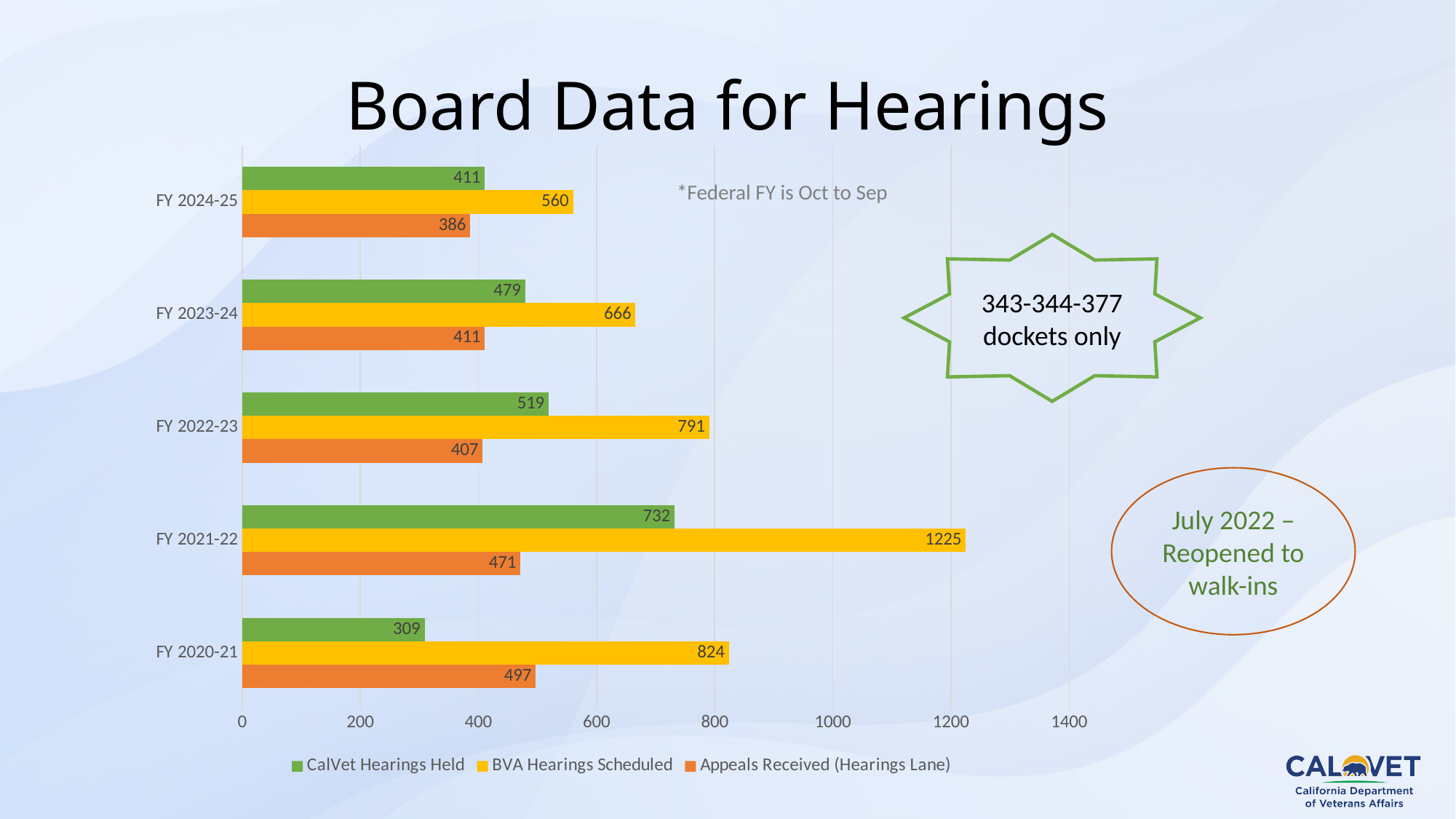
How many series does the legend list? 3 What is the value for CalVet Hearings Held in FY 2024-25? 411 What is the difference between BVA Hearings Scheduled and CalVet Hearings Held in FY 2022-23? 272 How many fiscal years are shown on the chart? 5 Which fiscal year has the lowest value for BVA Hearings Scheduled? FY 2024-25 What is the value for Appeals Received (Hearings Lane) in FY 2020-21? 497 Is the value for BVA Hearings Scheduled in FY 2020-21 greater or less than 800? greater Which is larger in FY 2023-24: CalVet Hearings Held or Appeals Received (Hearings Lane)? CalVet Hearings Held Which fiscal year has the highest value for CalVet Hearings Held? FY 2021-22 What is the value for BVA Hearings Scheduled in FY 2021-22? 1225 What is the title of the chart? Board Data for Hearings What kind of chart is shown on the slide? Bar chart